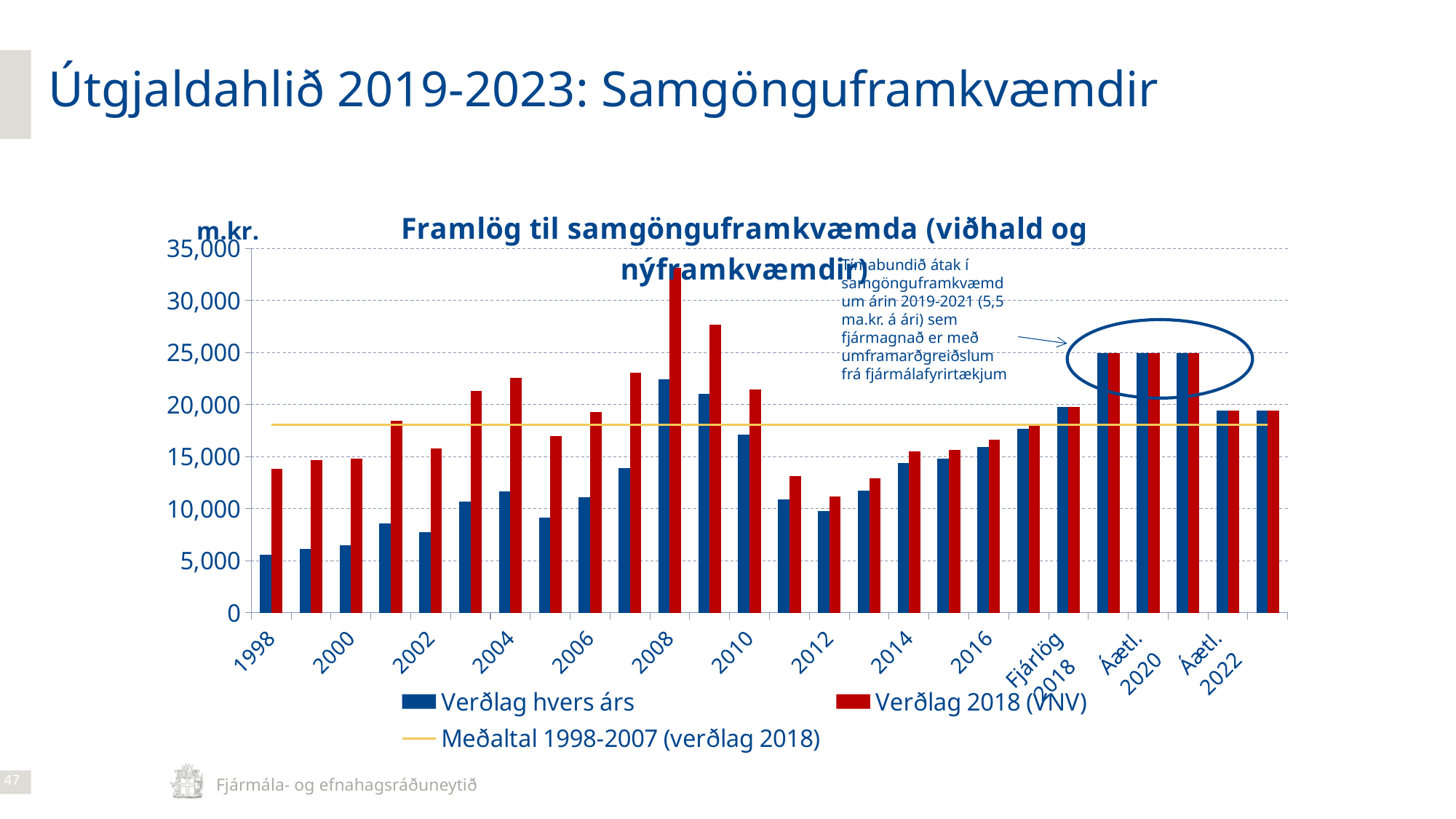
What kind of chart is shown on the slide? combination bar and line chart How many series does the chart legend list? 3 What is the title of the chart? Framlög til samgönguframkvæmda (viðhald og nýframkvæmdir) In which year is the Verðlag 2018 (VNV) value highest? 2008 Is the Verðlag hvers árs value for 1998 greater or less than 10,000? less In which year is the Verðlag hvers árs value lowest? 1998 Is the Verðlag 2018 (VNV) value for 2004 greater or less than 20,000? greater Is the Verðlag 2018 (VNV) value for 2008 greater or less than 30,000? greater Does the Verðlag hvers árs series generally rise or fall from 1998 to 2008? rise Which series is drawn as a yellow horizontal line? Meðaltal 1998-2007 (verðlag 2018) Which is larger, the Verðlag 2018 (VNV) value for 2008 or for 2009? 2008